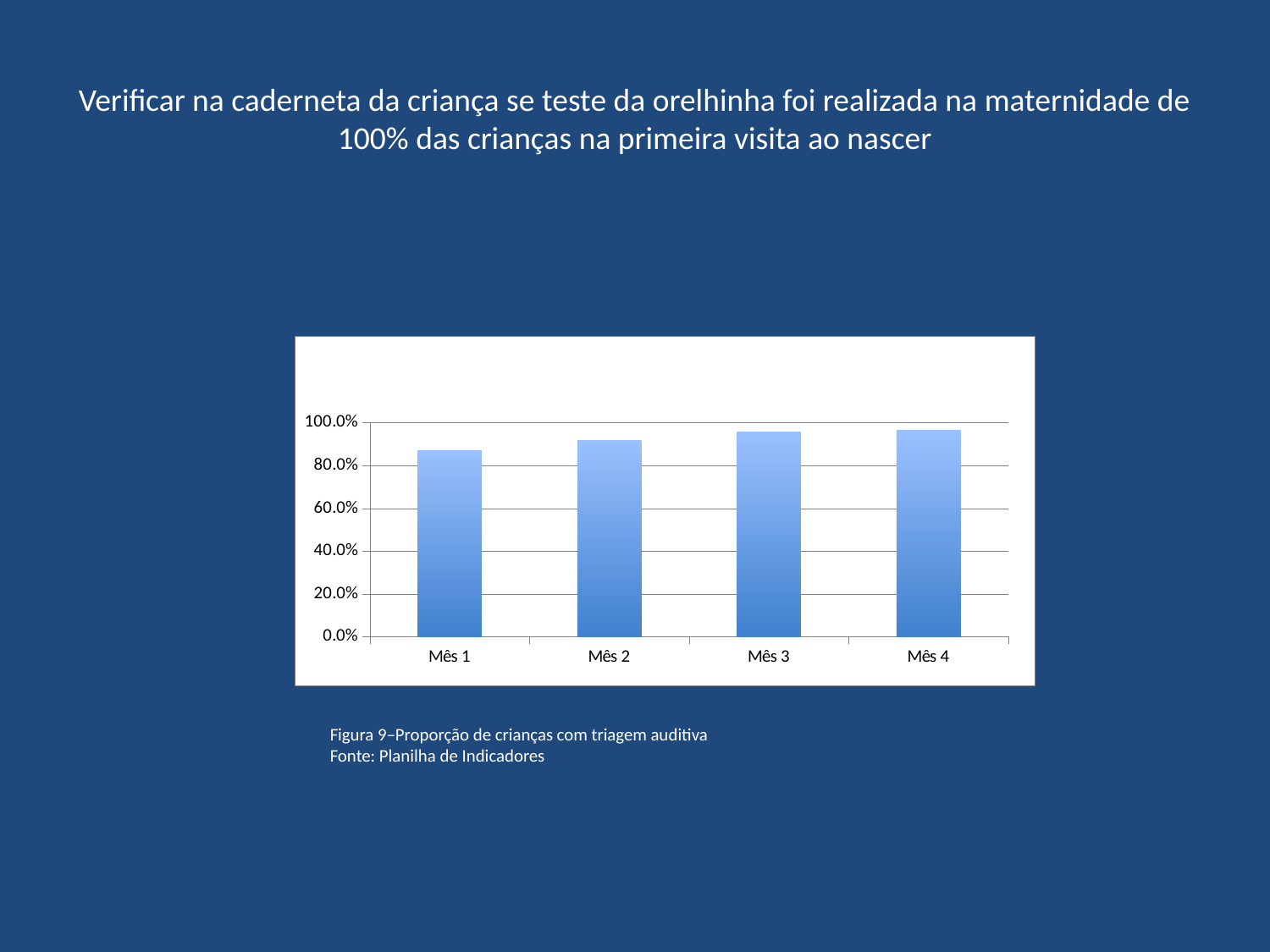
Is the value for Mês 4 greater or less than 100.0%? less What kind of chart is shown on the slide? bar chart How many categories (months) are plotted on the chart? 4 Which month has the lowest bar on the chart? Mês 1 Do the values rise or fall from Mês 1 to Mês 4? rise Is the value for Mês 1 greater or less than 100.0%? less What source is cited for the chart data? Planilha de Indicadores What is the figure caption given below the chart? Figura 9–Proporção de crianças com triagem auditiva Is the value for Mês 1 greater or less than 80.0%? greater Which is larger, the value for Mês 1 or the value for Mês 2? Mês 2 Which is larger, the value for Mês 2 or the value for Mês 4? Mês 4